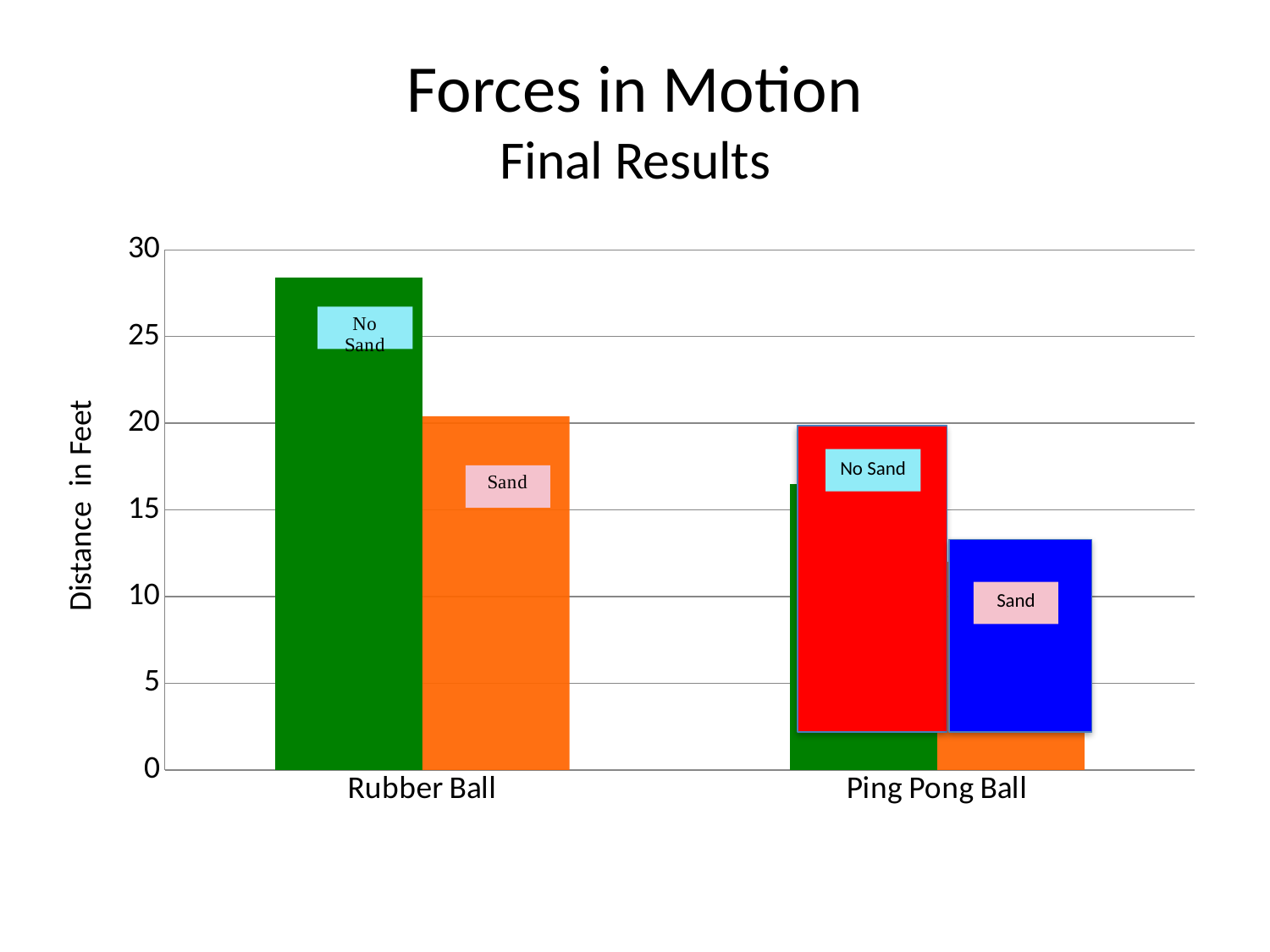
Is the No Sand value for Ping Pong Ball greater or less than 15? greater Which bar is the tallest in the chart? Rubber Ball, No Sand Which is larger: the No Sand value for Rubber Ball or the No Sand value for Ping Pong Ball? Rubber Ball What is the label of the y axis? Distance in Feet Is the No Sand value for Rubber Ball greater or less than 25? greater Which bar is the shortest in the chart? Ping Pong Ball, Sand What is the title shown above the chart? Forces in Motion Final Results Is the Sand value for Ping Pong Ball greater or less than 15? less For Rubber Ball, which is larger: the No Sand bar or the Sand bar? No Sand What kind of chart is shown on the slide? bar chart How many categories are shown on the x axis? 2